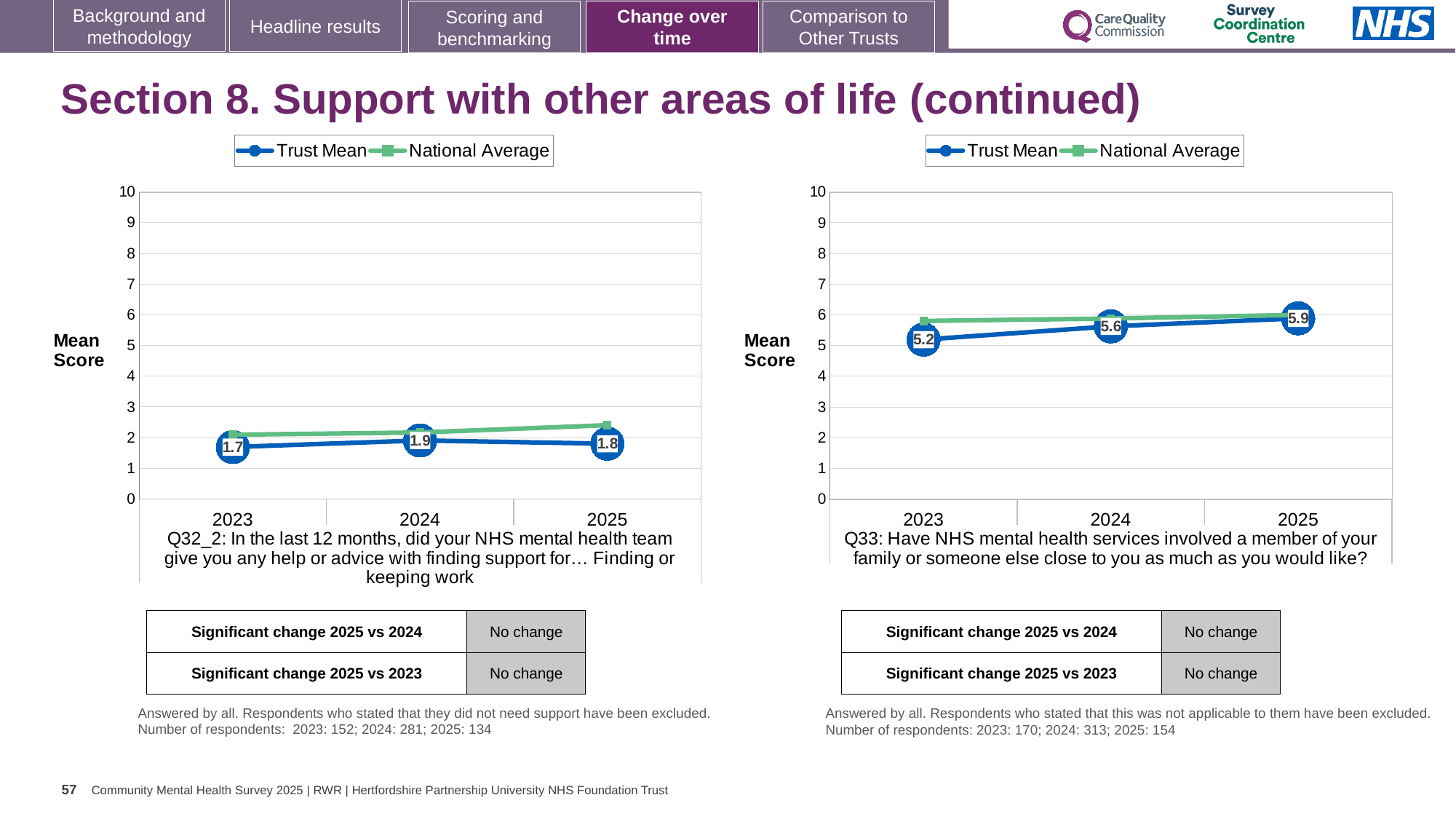
In the left chart (Q32_2), what is the Trust Mean for 2023? 1.7 What type of chart is used for Q33 on the right? line chart In the right chart (Q33), what is the Trust Mean for 2023? 5.2 In the left chart (Q32_2), is the National Average for 2025 greater or less than 2? greater In the left chart (Q32_2), which year has the highest Trust Mean? 2024 In the right chart (Q33), what is the Trust Mean for 2025? 5.9 In the left chart (Q32_2), what is the Trust Mean for 2024? 1.9 In the right chart (Q33), which year has the lowest Trust Mean? 2023 In the right chart (Q33), what is the difference between the Trust Mean for 2025 and 2023? 0.7 How many series does the legend of the left chart list? 2 In the right chart (Q33), in 2023, which is higher: the Trust Mean or the National Average? National Average In the right chart (Q33), does the Trust Mean rise or fall from 2023 to 2025? rise